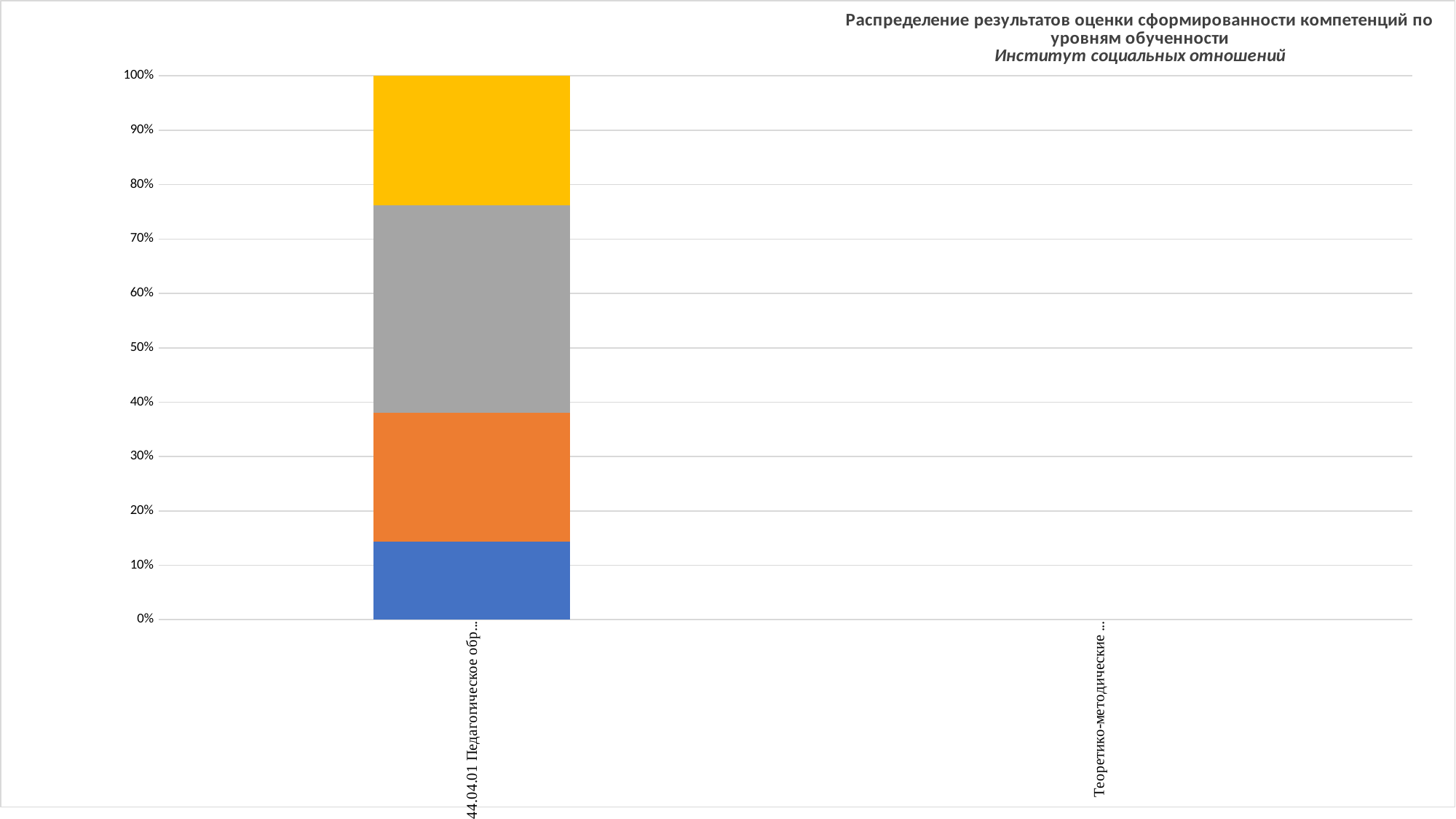
How many coloured segments make up the bar for the first category (44.04.01 Педагогическое обр...)? 4 Which institute is named in the chart title? Институт социальных отношений What is the total height of the stacked bar for the first category (44.04.01 Педагогическое обр...)? 100% Which coloured segment of the stacked bar is the largest? grey What kind of chart is shown on the slide? stacked bar chart Does the second category on the x axis (Теоретико-методические ...) have a visible bar? No How many categories are labelled on the x axis of the chart? 2 Is the top of the blue segment of the bar greater or less than 20%? less Is the top of the orange segment of the bar greater or less than 40%? less Is the top of the grey segment of the bar greater or less than 70%? greater Which coloured segment of the stacked bar is the smallest? blue Is the grey segment of the bar larger or smaller than the yellow segment? larger